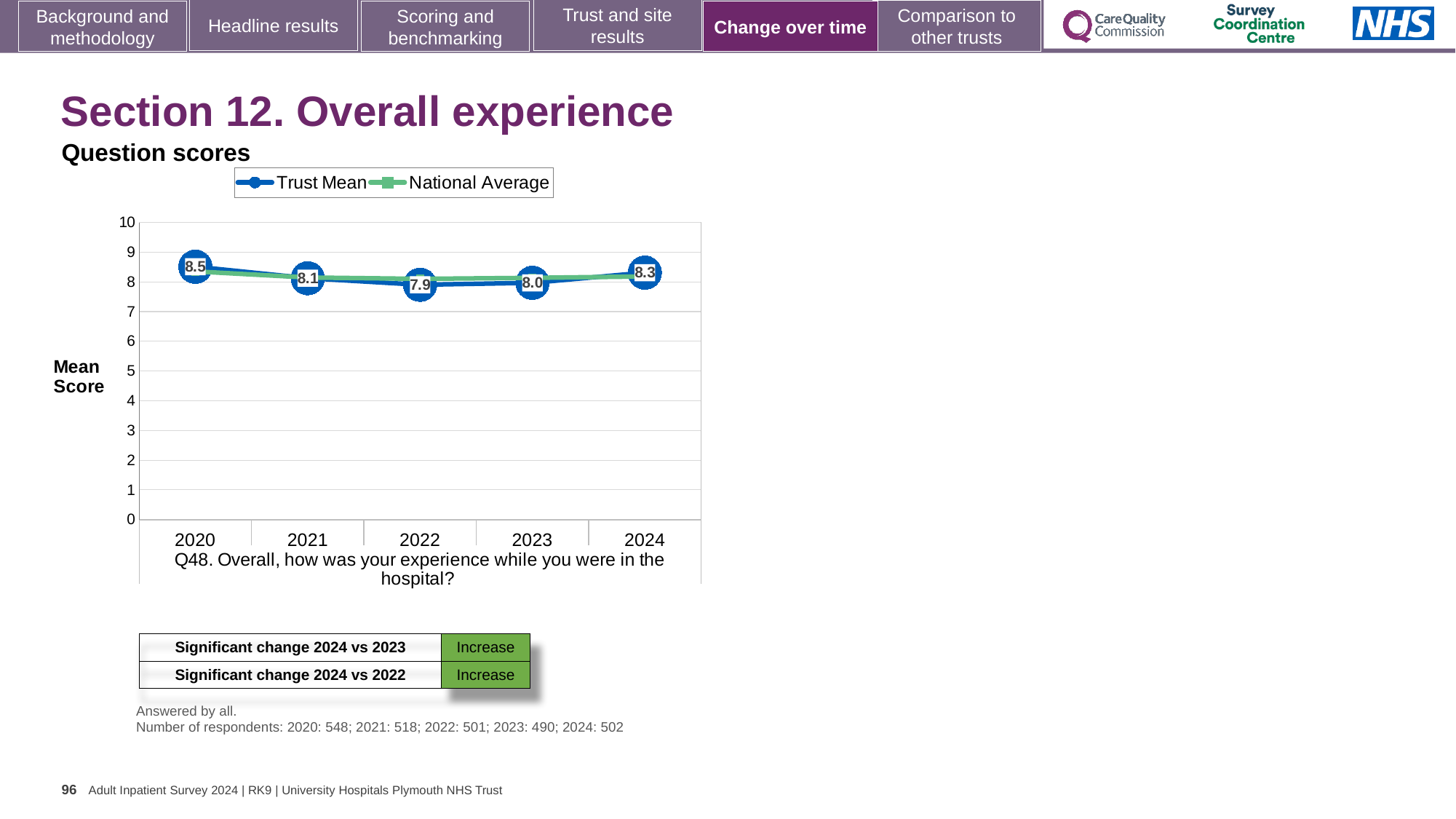
What is the Trust Mean score for 2022? 7.9 In which year is the Trust Mean score lowest? 2022 What kind of chart is shown? Line chart What is the Trust Mean score for 2020? 8.5 Which year has the larger Trust Mean score, 2021 or 2024? 2024 Does the Trust Mean score rise or fall from 2020 to 2022? Fall In which year is the Trust Mean score highest? 2020 How many series does the legend list? 2 Is the National Average value for 2023 greater or less than 5? greater What is the Trust Mean score for 2024? 8.3 How many years are plotted on the x axis? 5 What is the difference between the Trust Mean scores for 2020 and 2022? 0.6